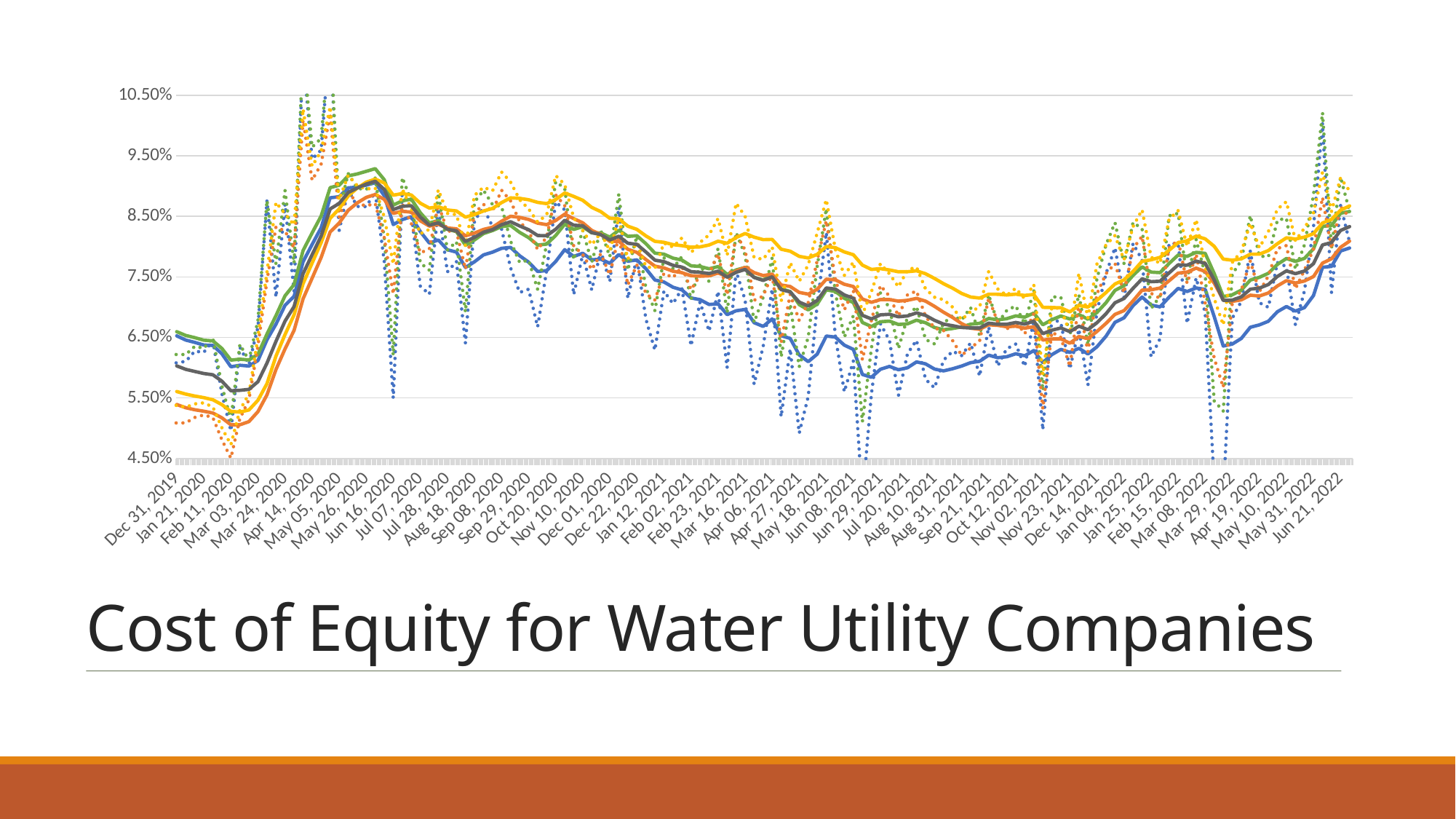
What kind of chart is shown on the slide? Line chart Does the chart display a legend identifying its series? No How many tick labels are shown on the y axis? 7 What is the title given on the slide for the chart? Cost of Equity for Water Utility Companies Do the values rise or fall along the x axis between Mar 03, 2020 and May 26, 2020? Rise At Jun 21, 2022, is the value of the lowest solid line greater or less than 7.50%? Greater At Jun 21, 2022, is the value of the highest solid line greater or less than 9.50%? Less Do the values rise or fall along the x axis between Jun 16, 2020 and Jun 29, 2021? Fall How many solid lines are plotted on the chart? 5 How many date labels are shown along the x axis? 44 At Dec 31, 2019, are the values of all the lines greater or less than 7.50%? Less Do the values rise or fall along the x axis between Nov 23, 2021 and Mar 08, 2022? Rise